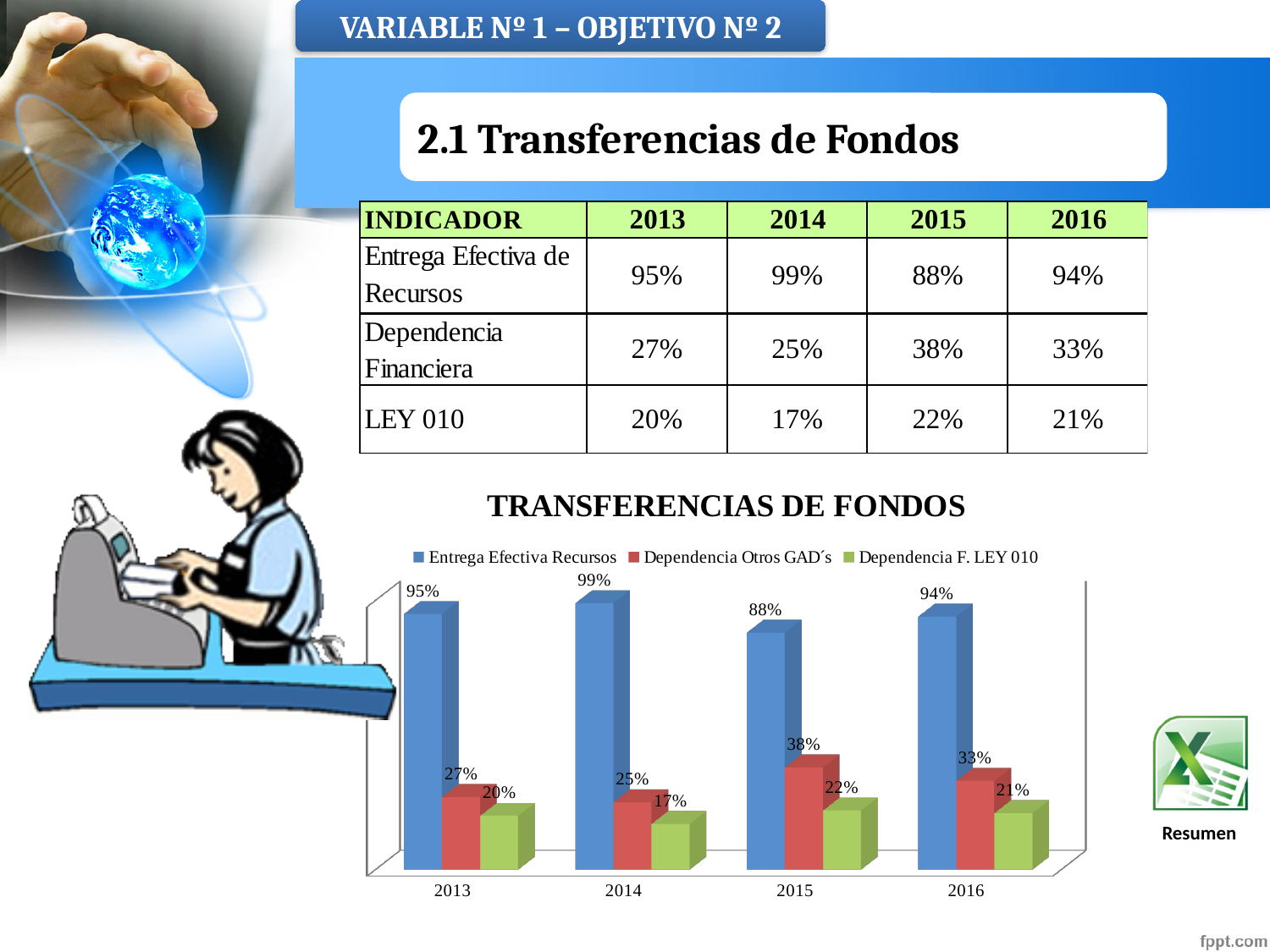
Does Dependencia F. LEY 010 rise or fall from 2013 to 2014 in the chart? Fall In which year is Entrega Efectiva Recursos lowest in the chart? 2015 Which series is shown in blue in the TRANSFERENCIAS DE FONDOS chart? Entrega Efectiva Recursos In which year is Dependencia Otros GAD´s highest in the chart? 2015 How many series does the legend of the TRANSFERENCIAS DE FONDOS chart list? 3 What is the difference between Entrega Efectiva Recursos in 2014 and in 2015? 11% How many years are shown on the x axis of the TRANSFERENCIAS DE FONDOS chart? 4 What is the value of Entrega Efectiva Recursos for 2014 in the chart? 99% What is the value of Dependencia F. LEY 010 for 2016 in the chart? 21% What type of chart is shown under the title TRANSFERENCIAS DE FONDOS? Bar chart What is the value of Dependencia Otros GAD´s for 2015 in the chart? 38% Which is larger in 2013: Dependencia Otros GAD´s or Dependencia F. LEY 010? Dependencia Otros GAD´s